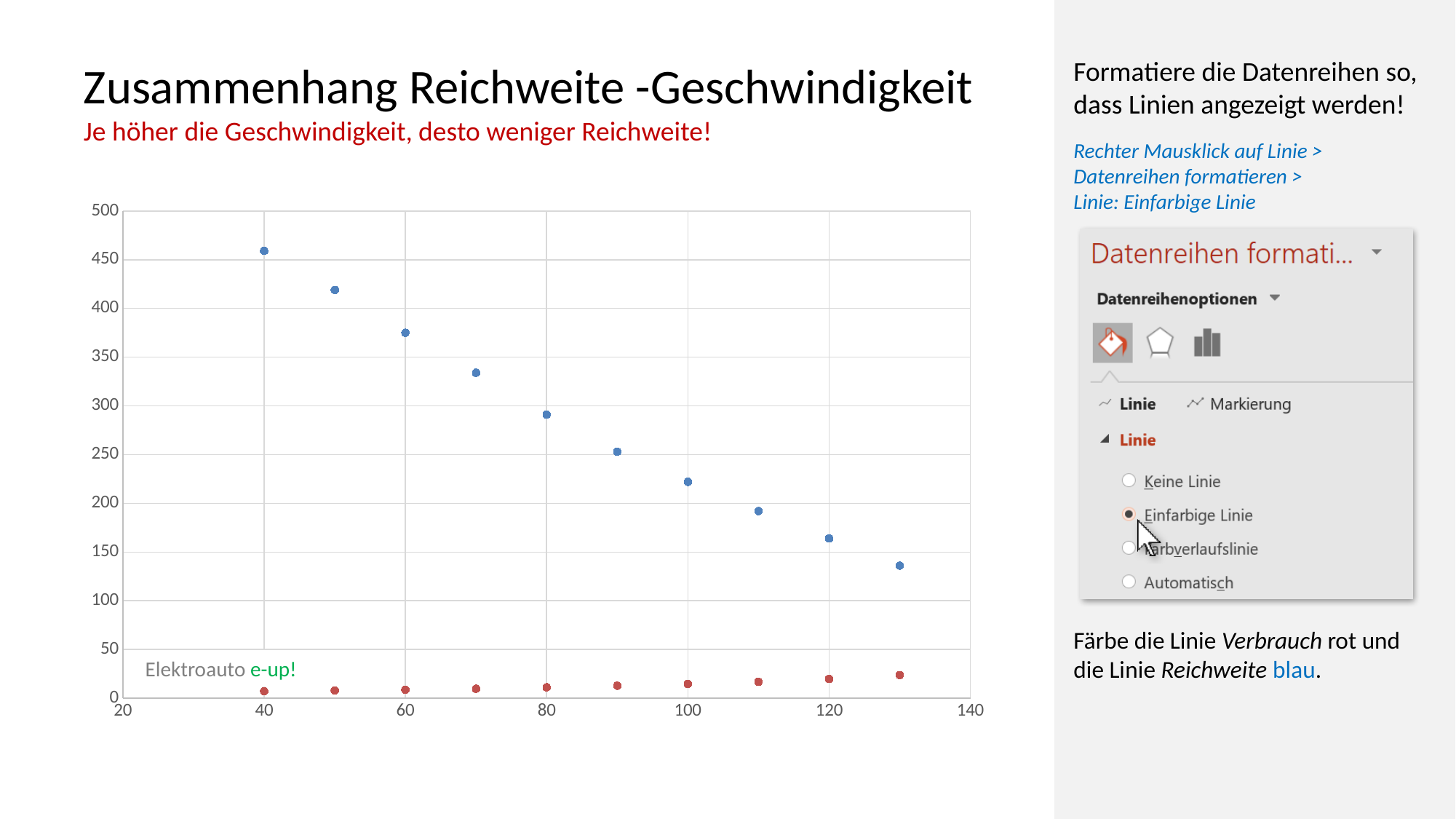
What kind of chart is shown on the slide? scatter chart How many blue data points are plotted in the chart? 10 Do the red points (Verbrauch) rise or fall as the x value increases? rise Do the blue points (Reichweite) rise or fall as the x value increases? fall Which is larger, the blue value at x = 80 or the blue value at x = 100? x = 80 Is the blue value at x = 130 greater or less than 150? less What is the title of the slide above the chart? Zusammenhang Reichweite -Geschwindigkeit At which x value is the blue series (Reichweite) lowest? 130 Is the blue value at x = 40 greater or less than 400? greater At which x value is the blue series (Reichweite) highest? 40 How many data series are plotted in the chart? 2 Is the red value at x = 130 greater or less than 50? less